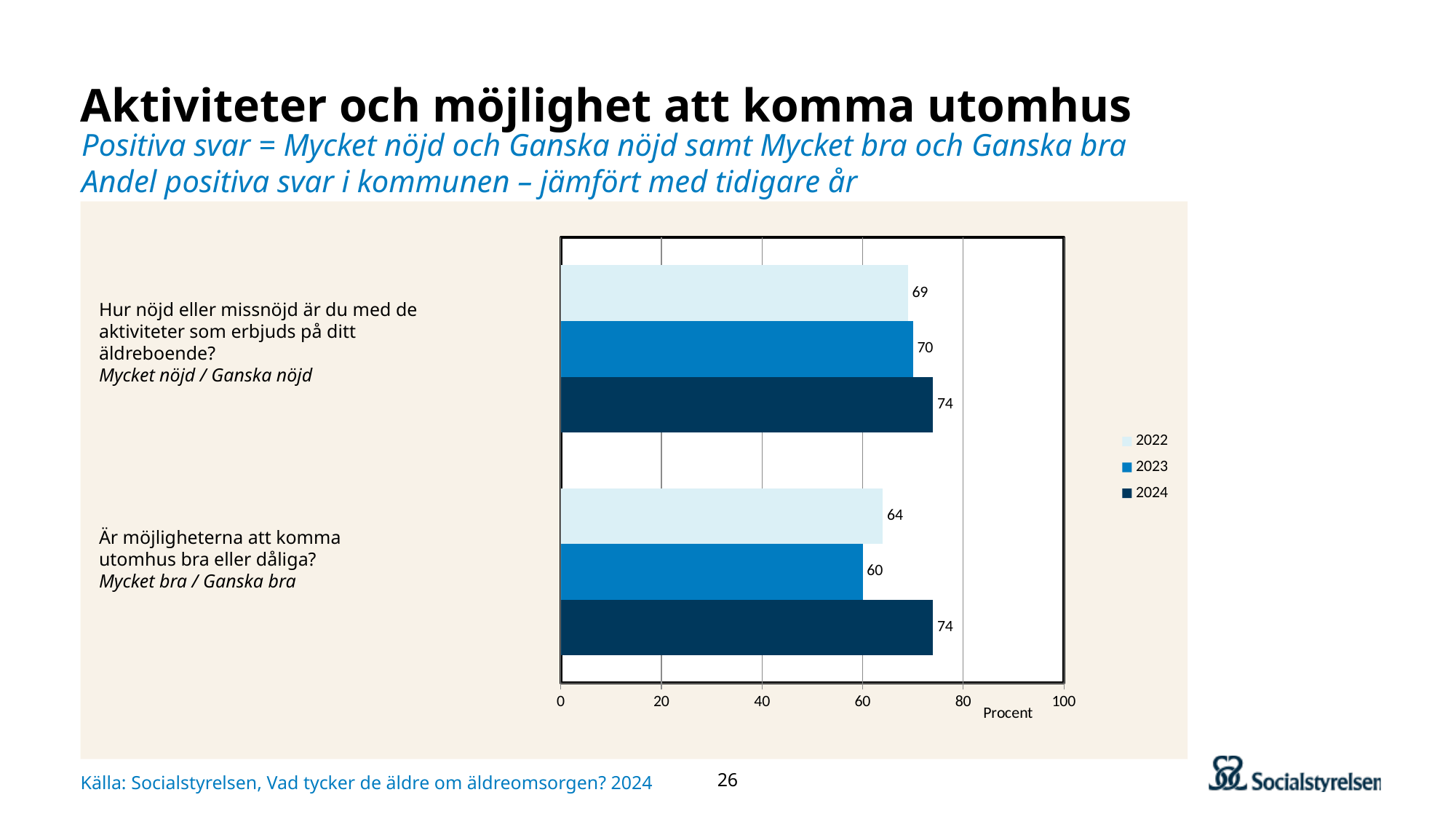
Is the 2023 value for satisfaction with activities greater or less than 60? greater Which year has the highest value for the question about satisfaction with activities? 2024 What is the label on the horizontal axis of the chart? Procent How many series does the legend list? 3 What kind of chart is shown on the slide? Bar chart What is the difference between the 2024 and 2022 values for the question about satisfaction with activities? 5 What is the difference between the 2024 and 2023 values for the question about opportunities to get outdoors? 14 What is the 2023 value for the question about opportunities to get outdoors ("Är möjligheterna att komma utomhus bra eller dåliga?")? 60 Which year has the lowest value for the question about opportunities to get outdoors? 2023 What is the 2024 value for the question about satisfaction with activities offered at the care home ("Hur nöjd eller missnöjd är du med de aktiviteter som erbjuds på ditt äldreboende?")? 74 Which is larger: the 2022 value for satisfaction with activities or the 2022 value for opportunities to get outdoors? Satisfaction with activities (69) What is the 2022 value for the question about opportunities to get outdoors? 64